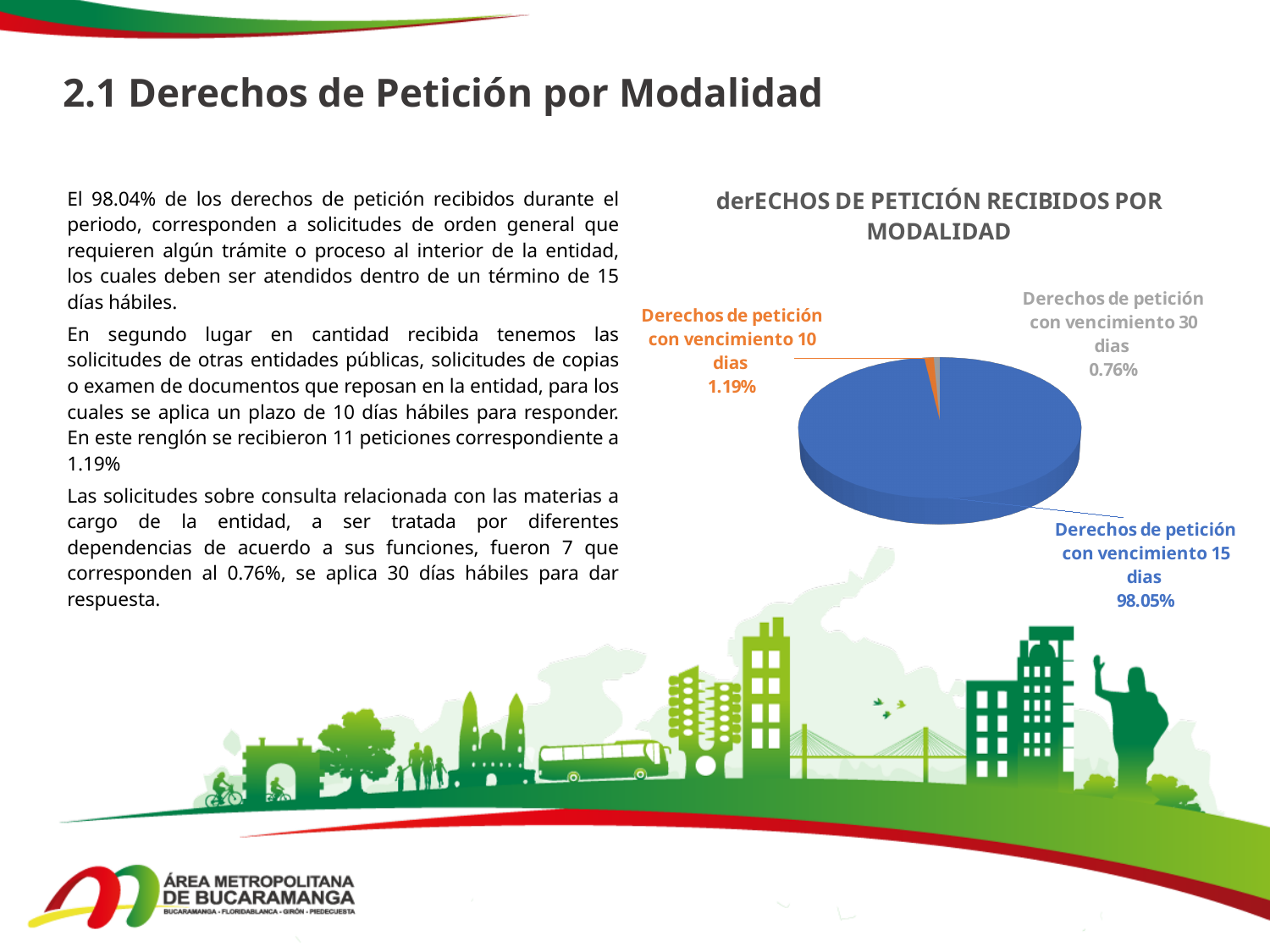
How many slices does the pie chart have? 3 What share of the pie is labelled for 'Derechos de petición con vencimiento 10 dias'? 1.19% Which slice is larger: 'Derechos de petición con vencimiento 10 dias' or 'Derechos de petición con vencimiento 30 dias'? Derechos de petición con vencimiento 10 dias Which category has the largest slice of the pie? Derechos de petición con vencimiento 15 dias What share of the pie is labelled for 'Derechos de petición con vencimiento 30 dias'? 0.76% What is the difference in percentage points between the 15 dias slice and the 10 dias slice? 96.86 What share of the pie is labelled for 'Derechos de petición con vencimiento 15 dias'? 98.05% What kind of chart is shown on the slide? Pie chart What is the title of the chart? derECHOS DE PETICIÓN RECIBIDOS POR MODALIDAD What is the difference in percentage points between the 10 dias slice and the 30 dias slice? 0.43 Which category has the smallest slice of the pie? Derechos de petición con vencimiento 30 dias What colour is the slice for 'Derechos de petición con vencimiento 15 dias'? Blue